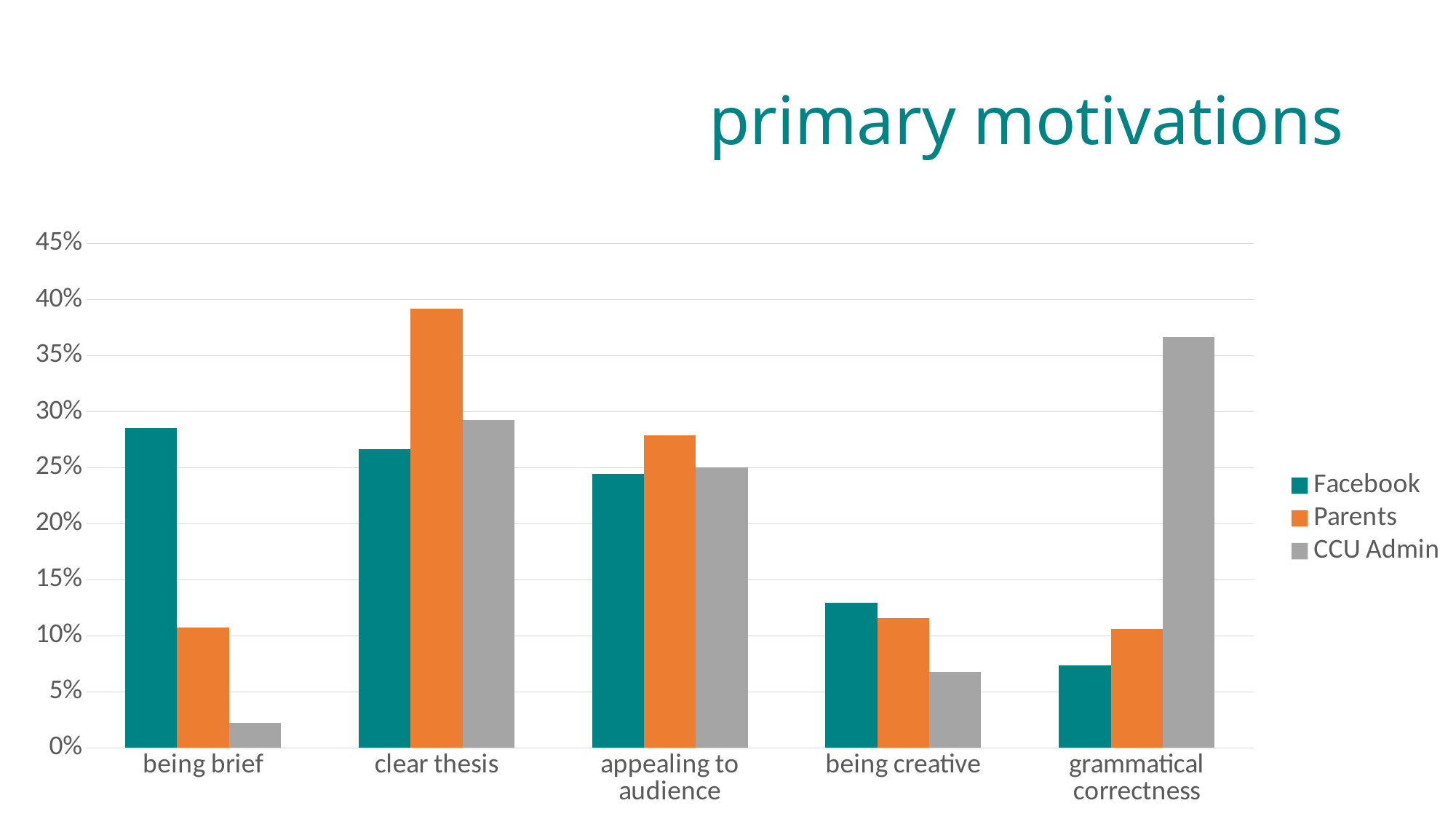
What is the title of the chart? primary motivations What kind of chart is shown on the slide? bar chart For 'being brief', which is larger: the Facebook value or the Parents value? Facebook How many series does the legend list? 3 For the Parents series, which category has the highest value? clear thesis Is the CCU Admin value for 'being brief' greater or less than 5%? less Is the Parents value for 'clear thesis' greater or less than 35%? greater For the CCU Admin series, which category has the lowest value? being brief For the CCU Admin series, which category has the highest value? grammatical correctness For 'grammatical correctness', which is larger: the CCU Admin value or the Facebook value? CCU Admin How many categories are shown on the x axis? 5 Is the Facebook value for 'appealing to audience' greater or less than 20%? greater